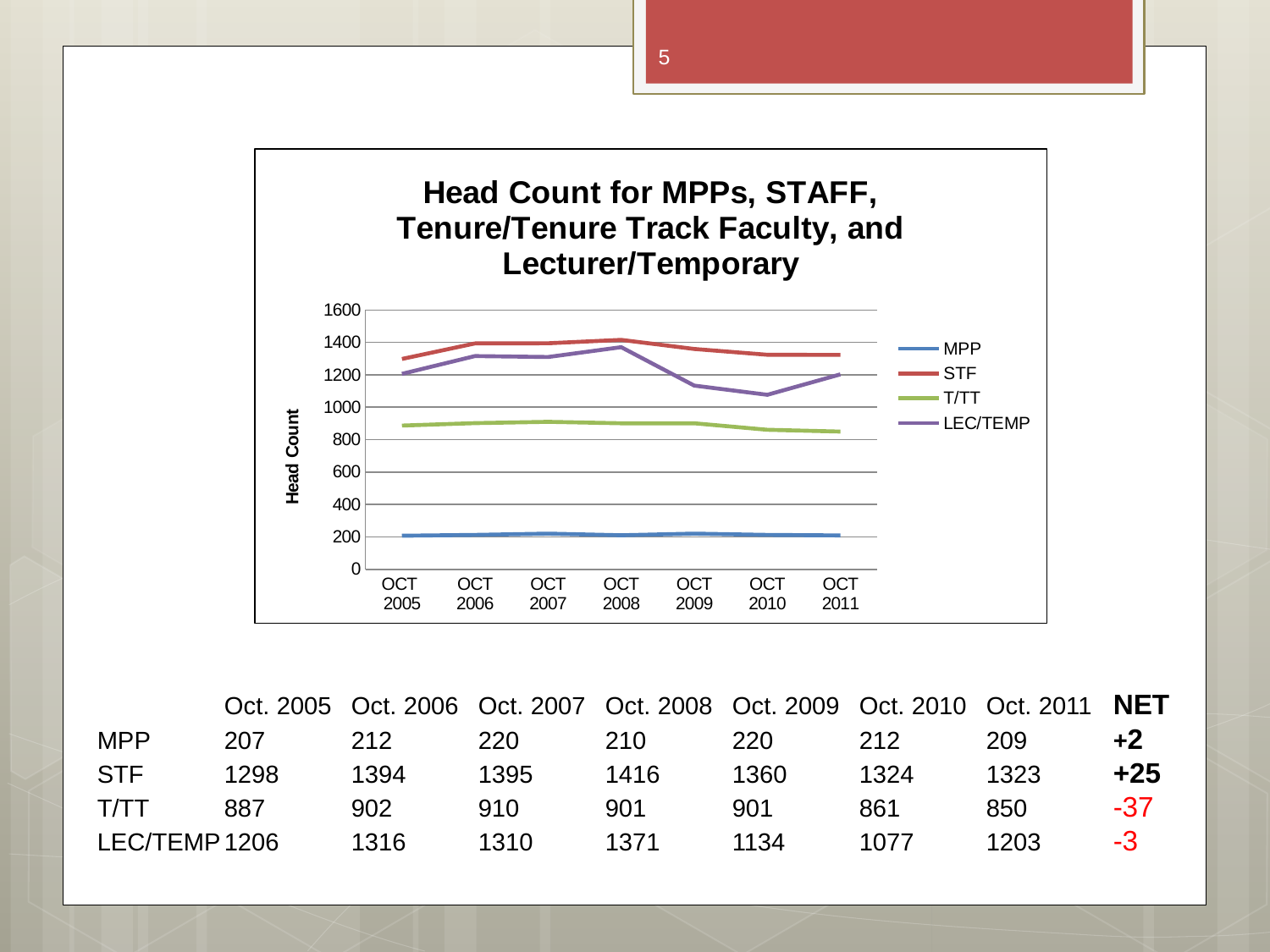
What is the title of the chart's vertical axis? Head Count What is the head count for MPP in Oct 2007? 220 Does the T/TT series rise or fall from Oct 2008 to Oct 2011? fall What is the difference between the STF and LEC/TEMP head counts in Oct 2009? 226 How many time points are plotted along the x axis of the chart? 7 How many series does the chart's legend list? 4 What kind of chart is shown on the slide? line chart Is the T/TT head count in Oct 2011 greater or less than 1000? less In which year does the STF series reach its highest head count? Oct. 2008 In which year does the LEC/TEMP series reach its lowest head count? Oct. 2010 Which series has the larger head count in Oct 2006, STF or LEC/TEMP? STF What is the head count for STF in Oct 2008? 1416